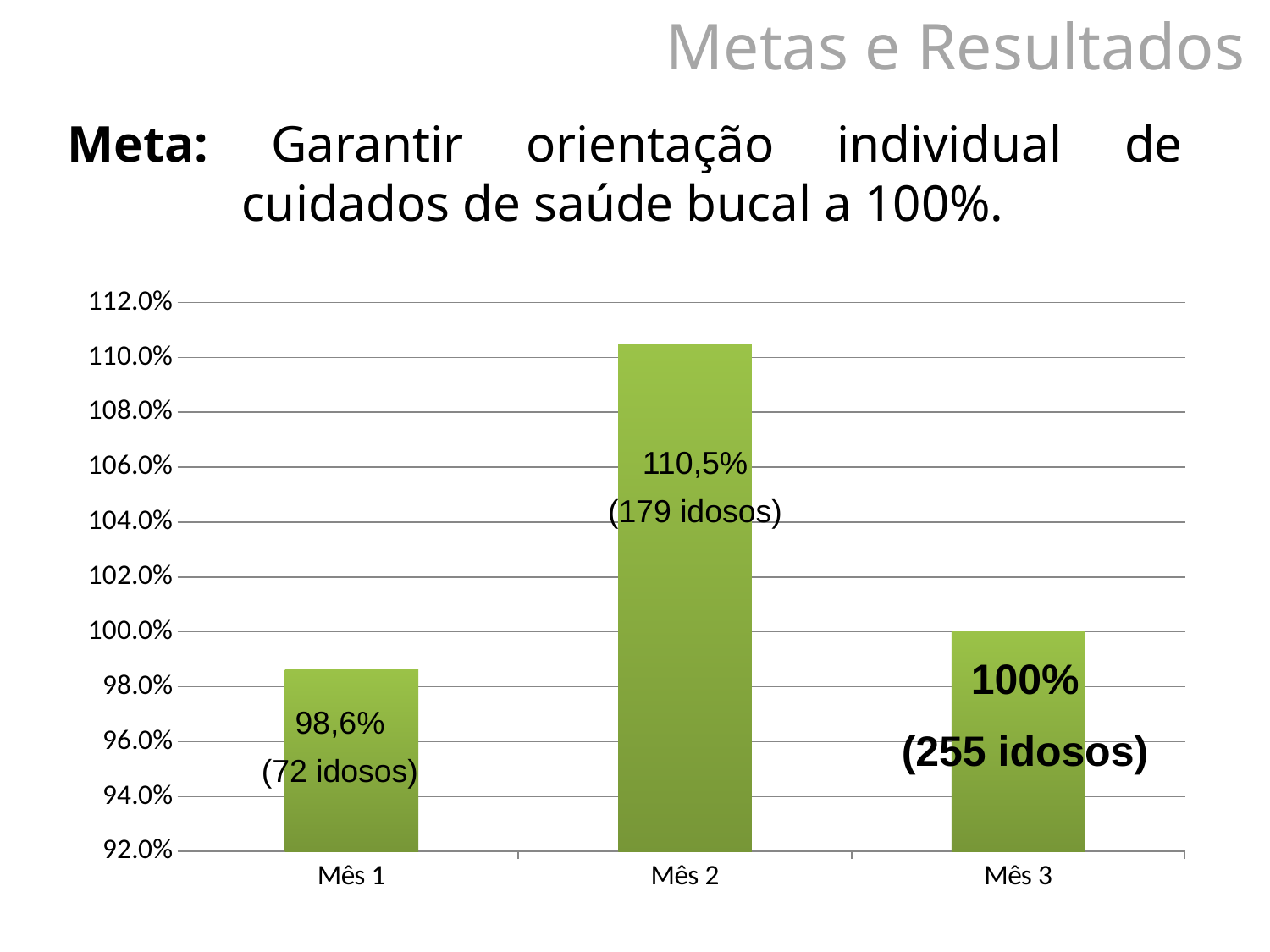
How many idosos are shown for Mês 3? 255 idosos Which is larger, the value for Mês 1 or Mês 3? Mês 3 Which month has the lowest value? Mês 1 What kind of chart is shown? bar chart How many categories are shown on the x axis? 3 Is the value for Mês 2 greater or less than 108.0%? greater What is the difference between the values for Mês 2 and Mês 1? 11,9% What is the value for Mês 3? 100% Which month has the highest value? Mês 2 What is the value for Mês 2? 110,5% How many idosos are shown for Mês 2? 179 idosos What is the value for Mês 1? 98,6%